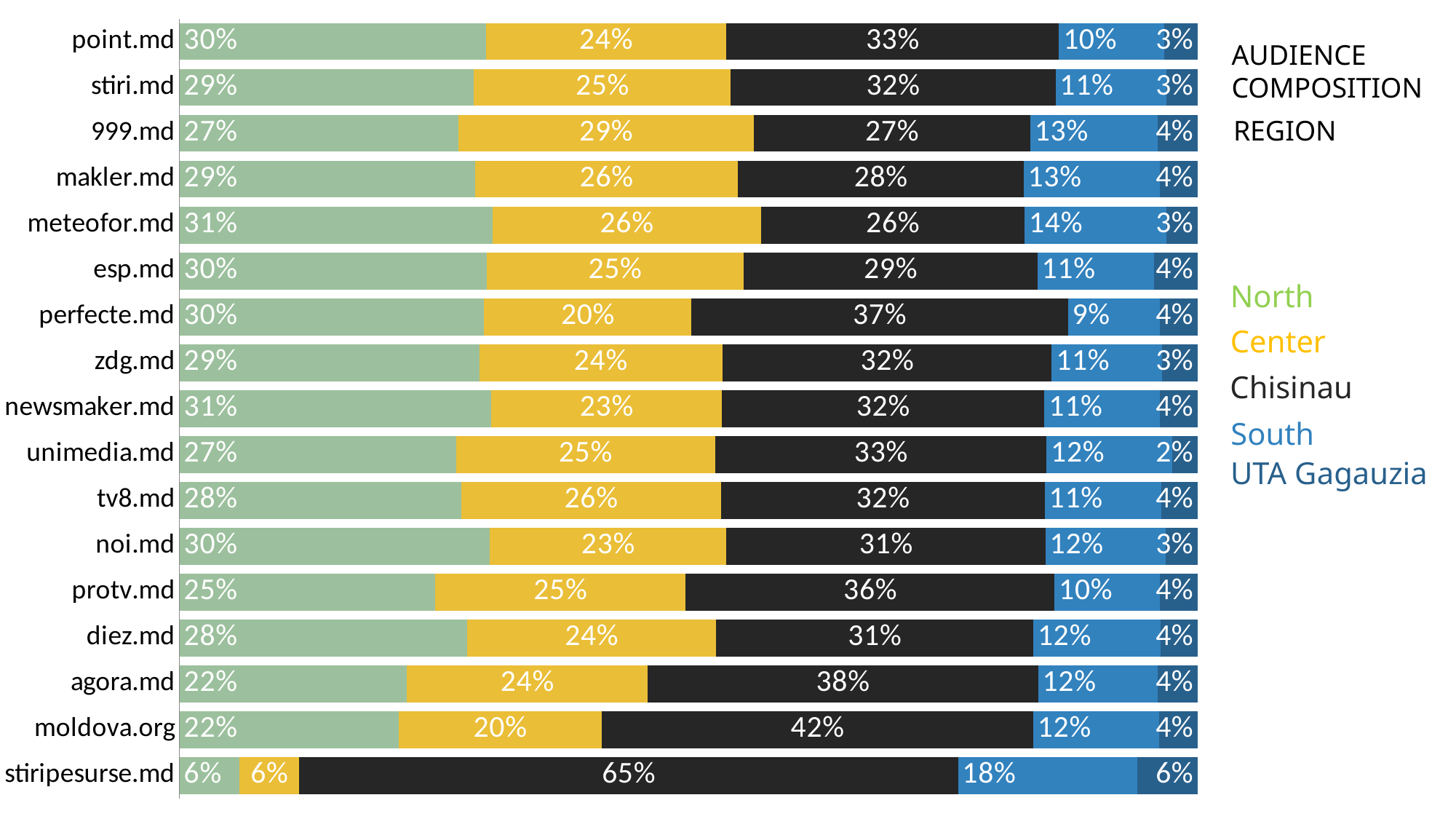
What is the Center share for 999.md? 29% Which colour represents the Center region in the chart? Yellow How many series does the legend list? 5 How many sites are shown on the chart? 17 What kind of chart is this? Stacked bar chart What is the difference between the Chisinau share of agora.md and that of point.md? 5% Which is larger: the Center share of perfecte.md or the Center share of makler.md? makler.md Which site has the lowest North share? stiripesurse.md Which site has the highest Chisinau share? stiripesurse.md What is the North share for meteofor.md? 31% What is the Chisinau share for moldova.org? 42% What is the South share for stiripesurse.md? 18%